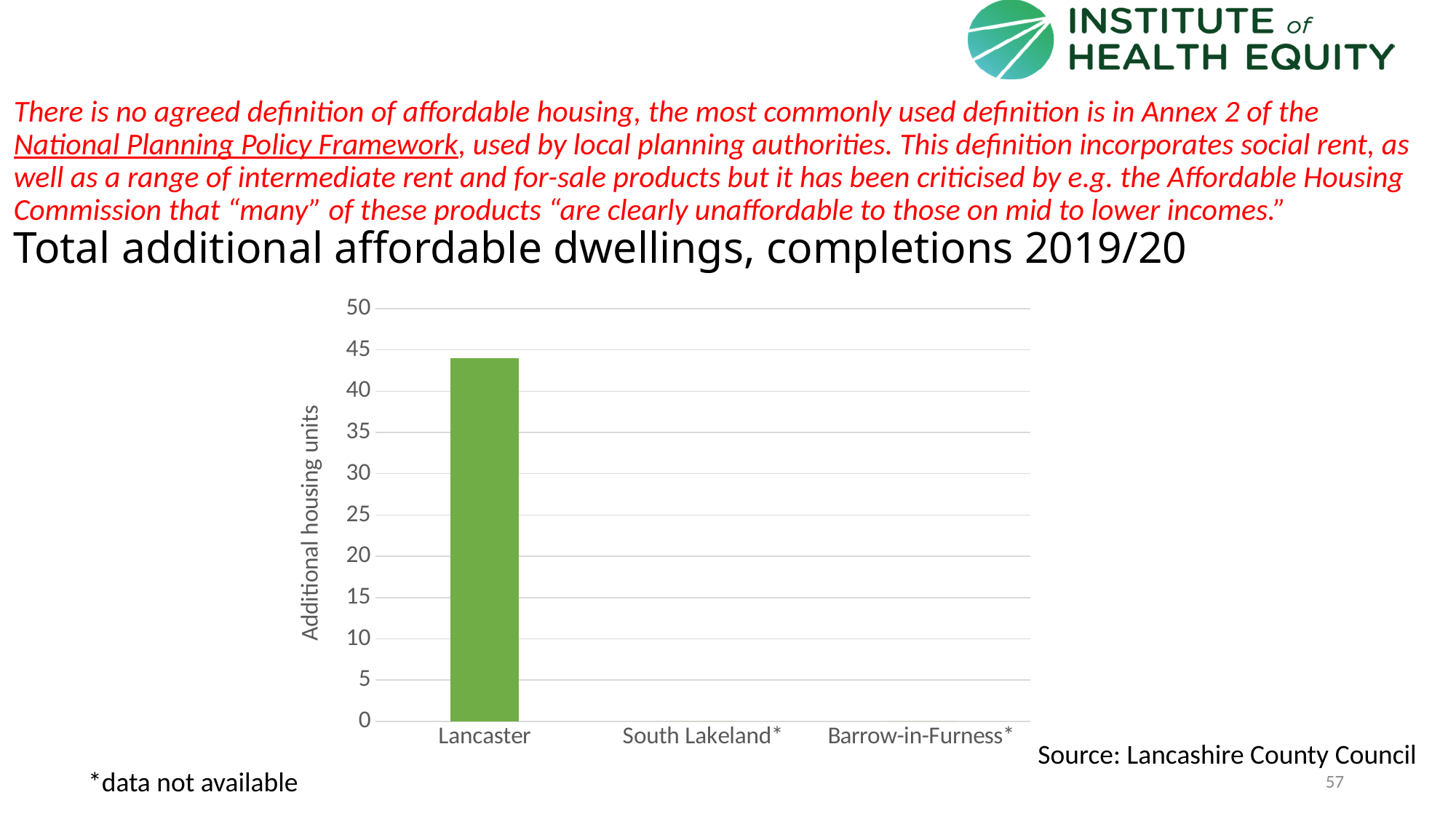
What is the title of the chart? Total additional affordable dwellings, completions 2019/20 What is the highest value shown on the y axis of the chart? 50 Is the value for Lancaster greater or less than 40? greater Which category is the only one with a bar plotted in the chart? Lancaster Is the value for Lancaster greater or less than 45? less Which category has the highest value in the chart? Lancaster How many categories are shown on the x axis of the chart? 3 What kind of chart is shown on the slide? bar chart What is the label on the y axis of the chart? Additional housing units Is the value for Lancaster greater or less than 30? greater